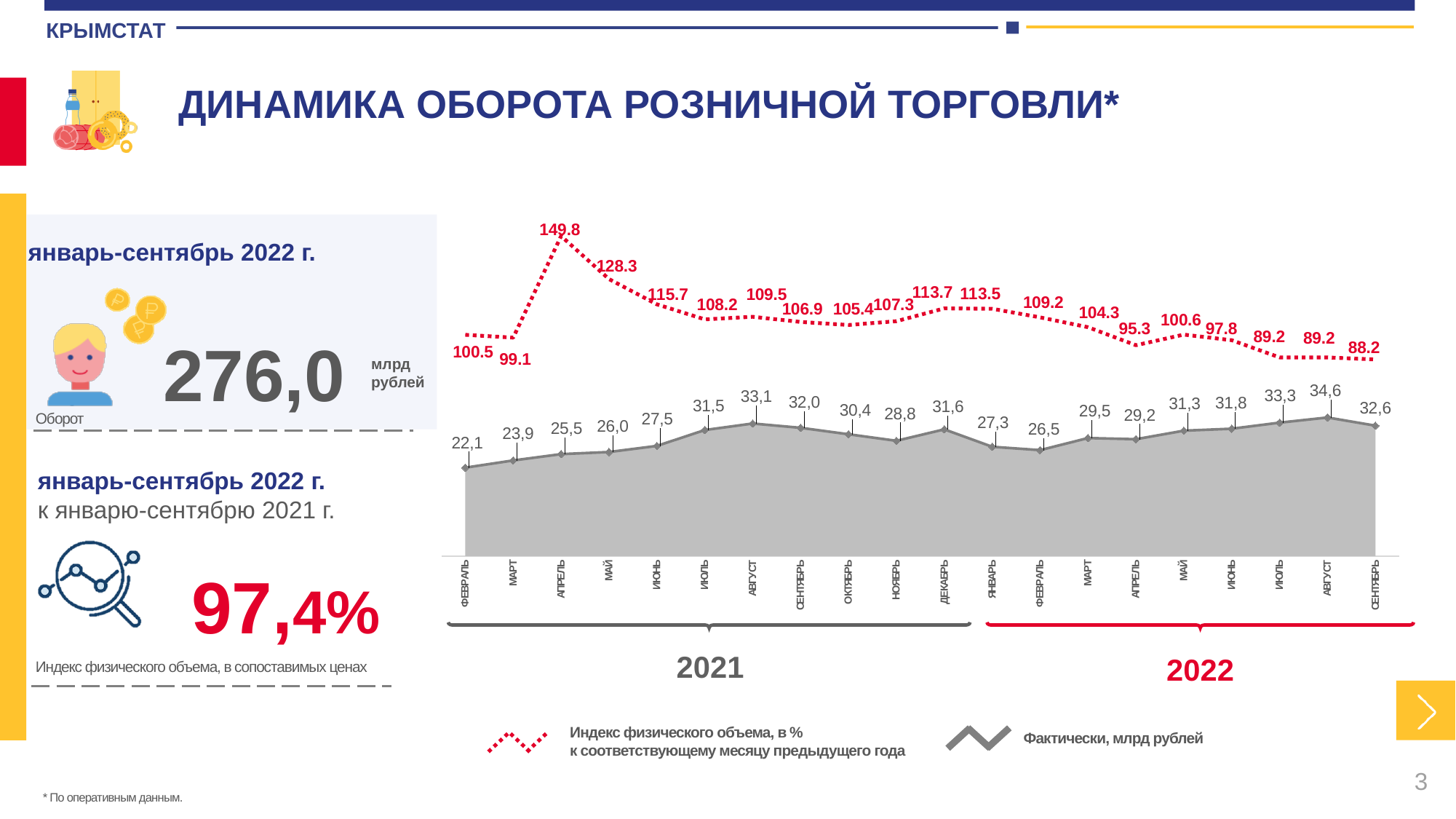
What is the actual retail turnover in billion rubles for February 2021? 22,1 How many series does the legend list? 2 What is the physical volume index (Индекс физического объема, в %) for April 2021? 149.8 Does the physical volume index rise or fall from January 2022 to September 2022? Fall What is the physical volume index for September 2022? 88.2 What is the difference between the actual turnover for August 2022 (34,6) and August 2021 (33,1)? 1,5 What is the actual retail turnover (Фактически, млрд рублей) for August 2022? 34,6 How many months (data points) are plotted on the chart? 20 In which month is the physical volume index (red dotted line) highest? Апрель 2021 What kind of chart is used to show the actual turnover in billion rubles? Area chart with a line Which is larger: the physical volume index for May 2021 or for June 2021? May 2021 In which month is the actual turnover in billion rubles (grey line) lowest? Февраль 2021